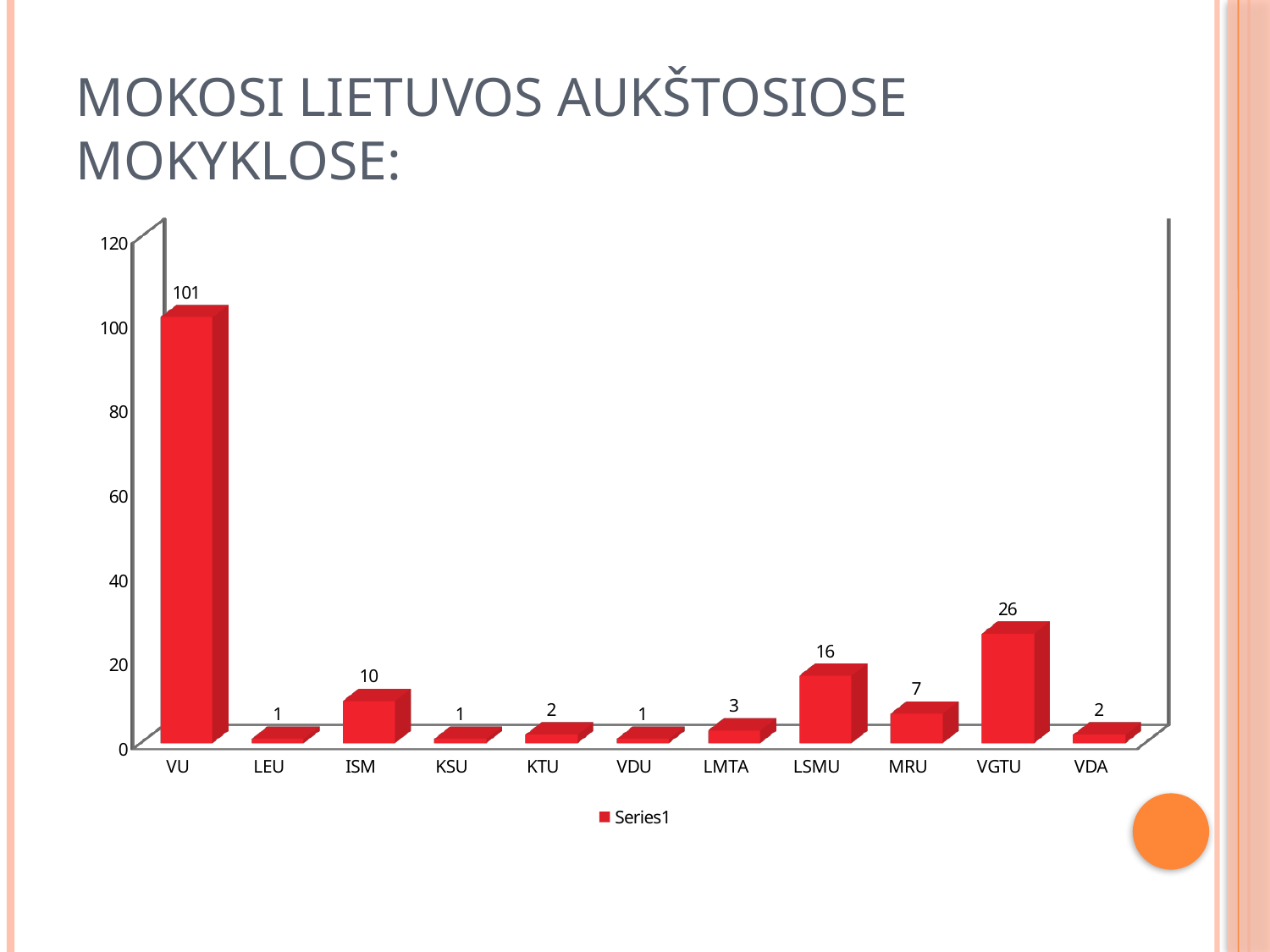
What is the value for LSMU? 16 What is the difference between the values for VU and VGTU? 75 What is the value for MRU? 7 How many categories are shown on the x axis? 11 What is the value for VU? 101 What is the legend entry shown below the chart? Series1 Which is larger, the value for VGTU or the value for LSMU? VGTU What is the difference between the values for LSMU and ISM? 6 What kind of chart is shown on the slide? bar chart What is the value for VGTU? 26 Which category has the highest value? VU Is the value for VU greater or less than 100? greater